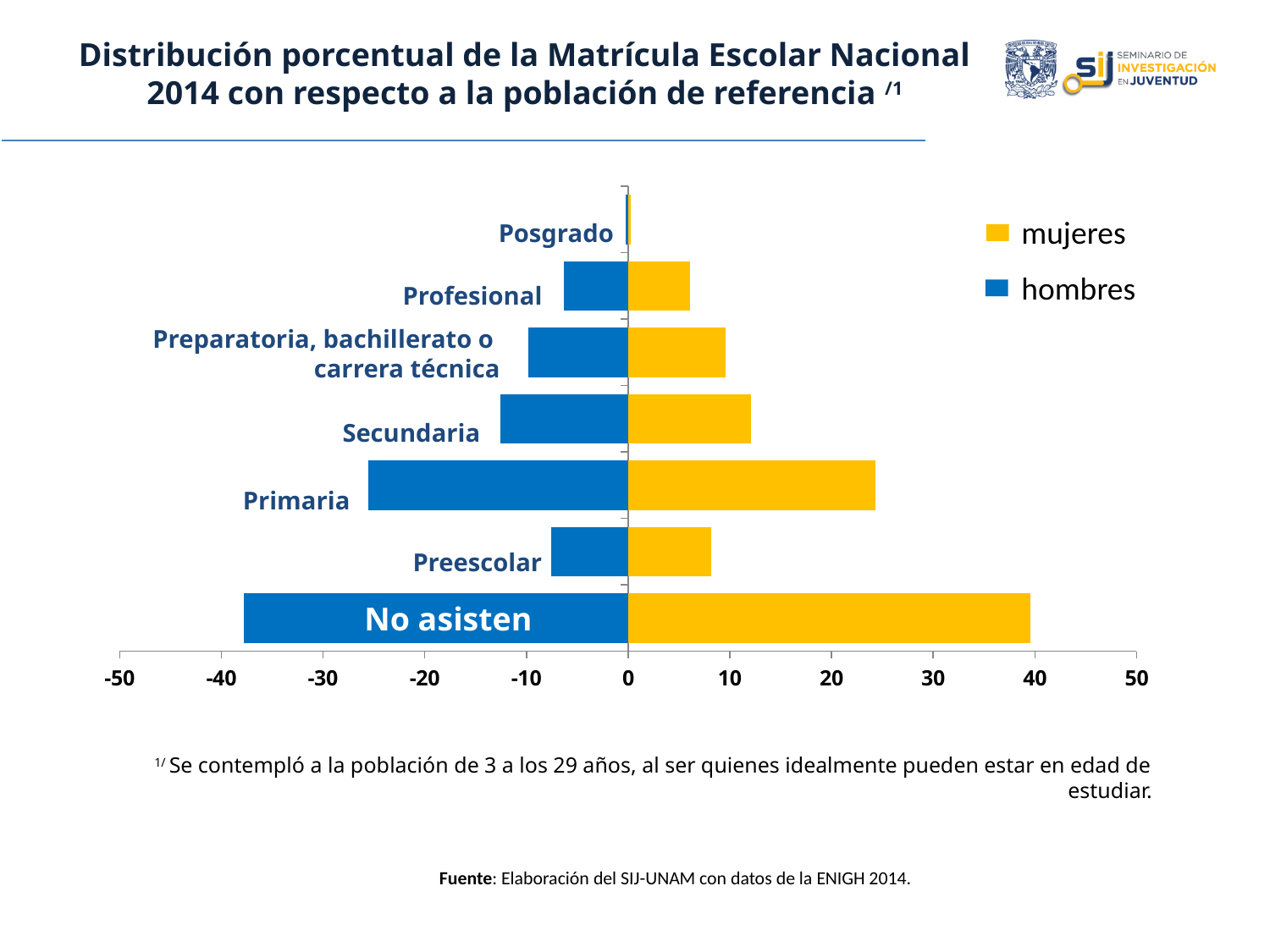
What are the two entries in the legend? mujeres and hombres Which is larger for mujeres: Primaria or Secundaria? Primaria Is the value for mujeres in Preescolar greater or less than 10? less Which category has the smallest value for mujeres? Posgrado How many series does the legend list? 2 Is the value for mujeres in Primaria greater or less than 20? greater What kind of chart is shown on the slide? bar chart Is the value for mujeres in No asisten greater or less than 30? greater How many education categories are plotted on the chart? 7 Which colour represents the mujeres series? yellow Which category has the highest value for mujeres? No asisten